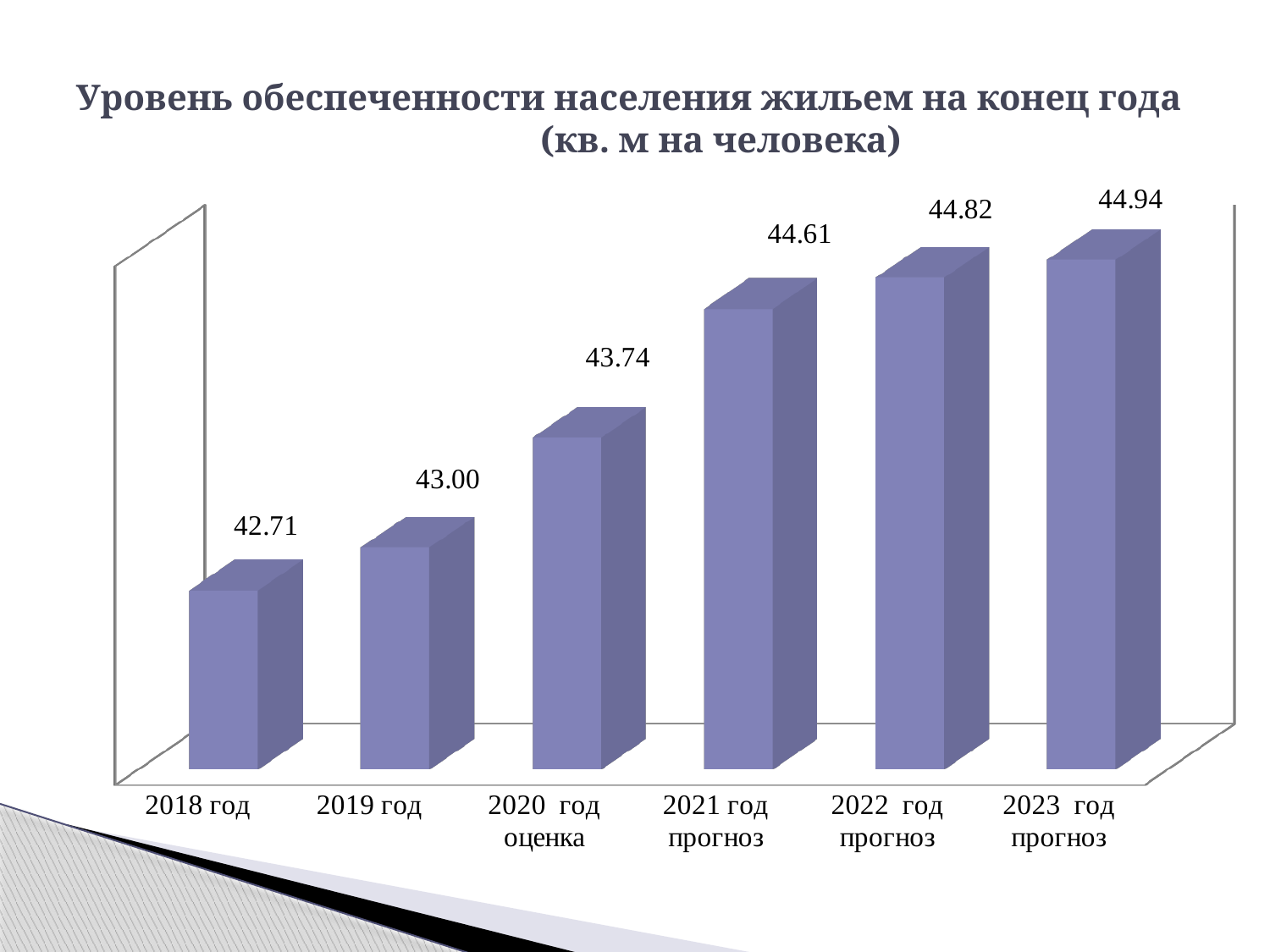
Do the values rise or fall from 2018 год to 2023 год прогноз? Rise What is the difference between the values for 2023 год прогноз and 2022 год прогноз? 0.12 How many bars are shown in the chart? 6 What is the difference between the values for 2021 год прогноз and 2018 год? 1.90 What kind of chart is shown on the slide? Bar chart What is the value for 2022 год прогноз? 44.82 Which is larger, the value for 2019 год or the value for 2020 год оценка? 2020 год оценка What is the value for 2018 год? 42.71 What is the title of the chart? Уровень обеспеченности населения жильем на конец года (кв. м на человека) What is the value for 2020 год оценка? 43.74 Which year has the lowest value? 2018 год Which year has the highest value? 2023 год прогноз